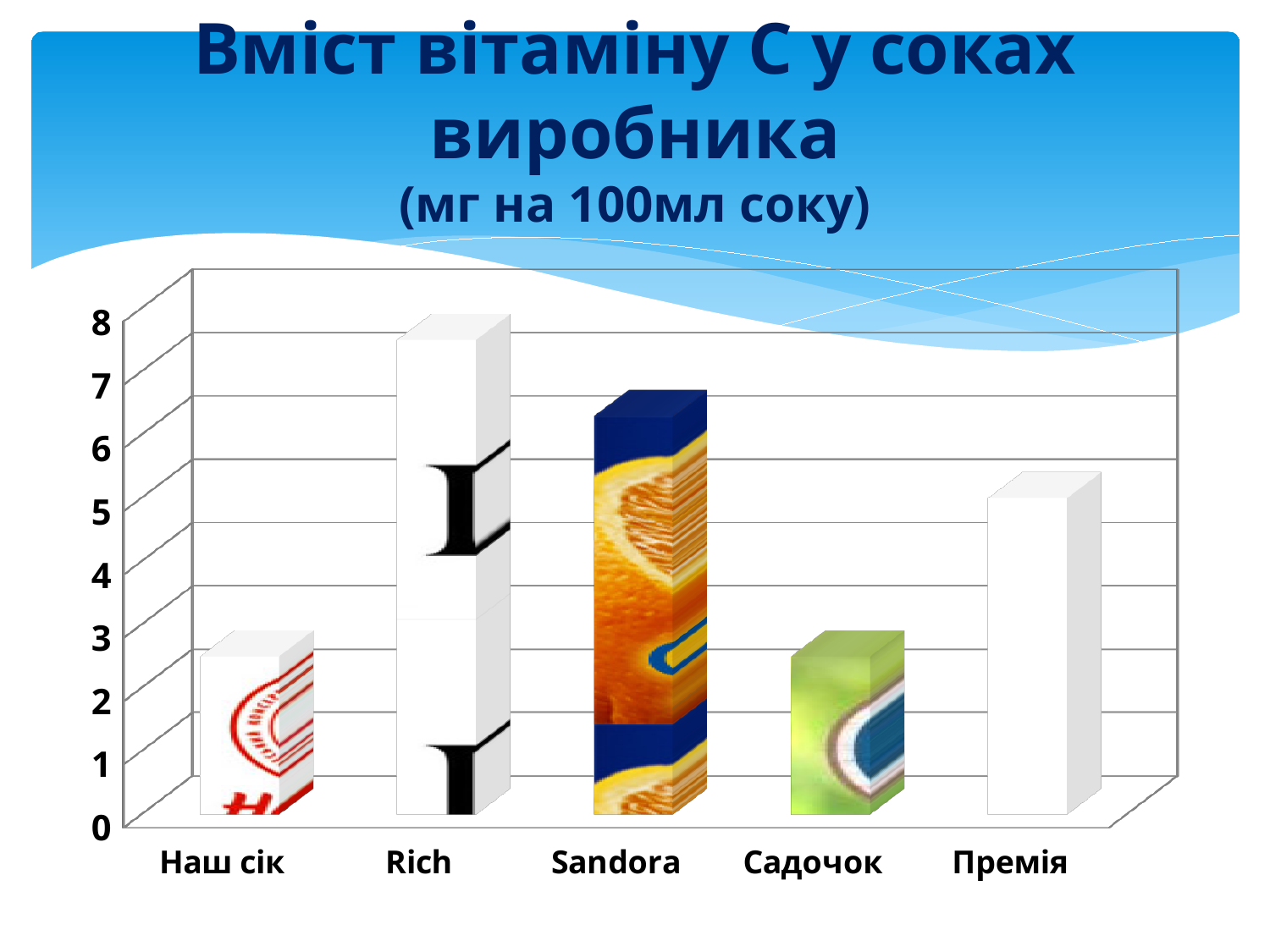
Is the value for Наш сік greater or less than 4? less Which has a higher vitamin C content, Rich or Sandora? Rich Which juice brand has the highest vitamin C content in the chart? Rich In what units are the values in the chart expressed, according to the title? мг на 100мл соку Is the value for Rich greater or less than 6? greater What kind of chart is shown on the slide? bar chart Which has a higher vitamin C content, Sandora or Премія? Sandora Is the value for Sandora greater or less than 5? greater How many juice brands are shown on the x axis of the chart? 5